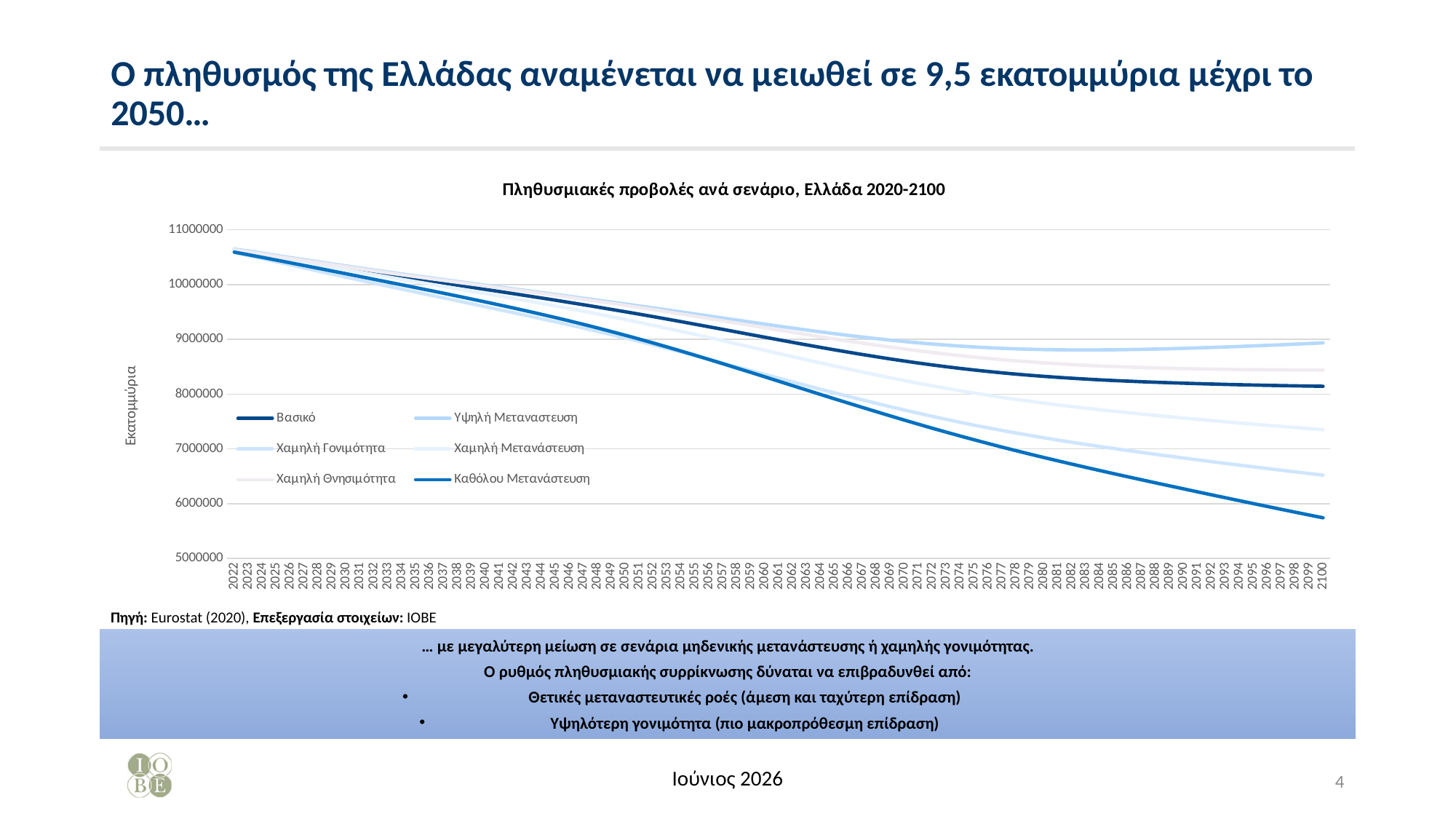
What kind of chart is shown on the slide? line chart Is the value for Καθόλου Μετανάστευση in 2100 greater or less than 6000000? less Which series has the lowest value in 2100? Καθόλου Μετανάστευση Is the value for Βασικό in 2100 greater or less than 8000000? greater In 2100, which is larger: Βασικό or Καθόλου Μετανάστευση? Βασικό How many series does the legend list? 6 Which series has the highest value in 2100? Υψηλή Μετανάστευση Does the Βασικό series rise or fall from 2022 to 2100? fall What is the label of the vertical axis? Εκατομμύρια Is the value for Βασικό in 2022 greater or less than 10000000? greater What is the title of the chart? Πληθυσμιακές προβολές ανά σενάριο, Ελλάδα 2020-2100